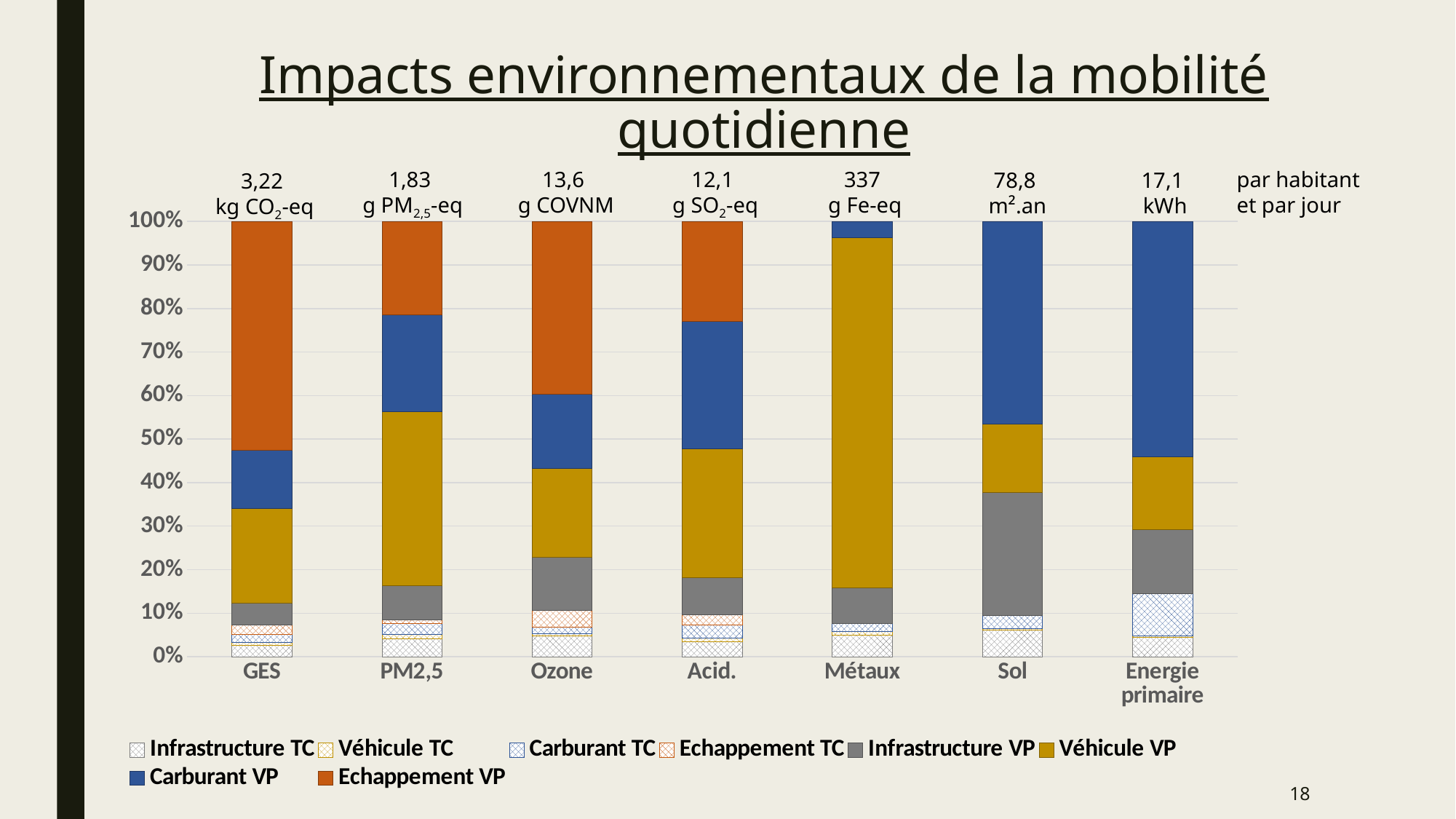
Is the share of Echappement VP in the Ozone bar greater or less than 30%? greater What kind of chart is shown on the slide? Stacked bar chart Which category has the larger share of Infrastructure VP, Sol or Energie primaire? Sol What total value is printed above the GES bar? 3,22 kg CO2-eq Is the share of Carburant VP in the Ozone bar greater or less than 20%? less Which category has the largest share of Véhicule VP? Métaux Is the share of Véhicule VP in the Métaux bar greater or less than 70%? greater How many series does the legend list? 8 What total value is printed above the Energie primaire bar? 17,1 kWh What total value is printed above the Sol bar? 78,8 m².an How many impact categories are shown along the x axis? 7 What total value is printed above the Métaux bar? 337 g Fe-eq